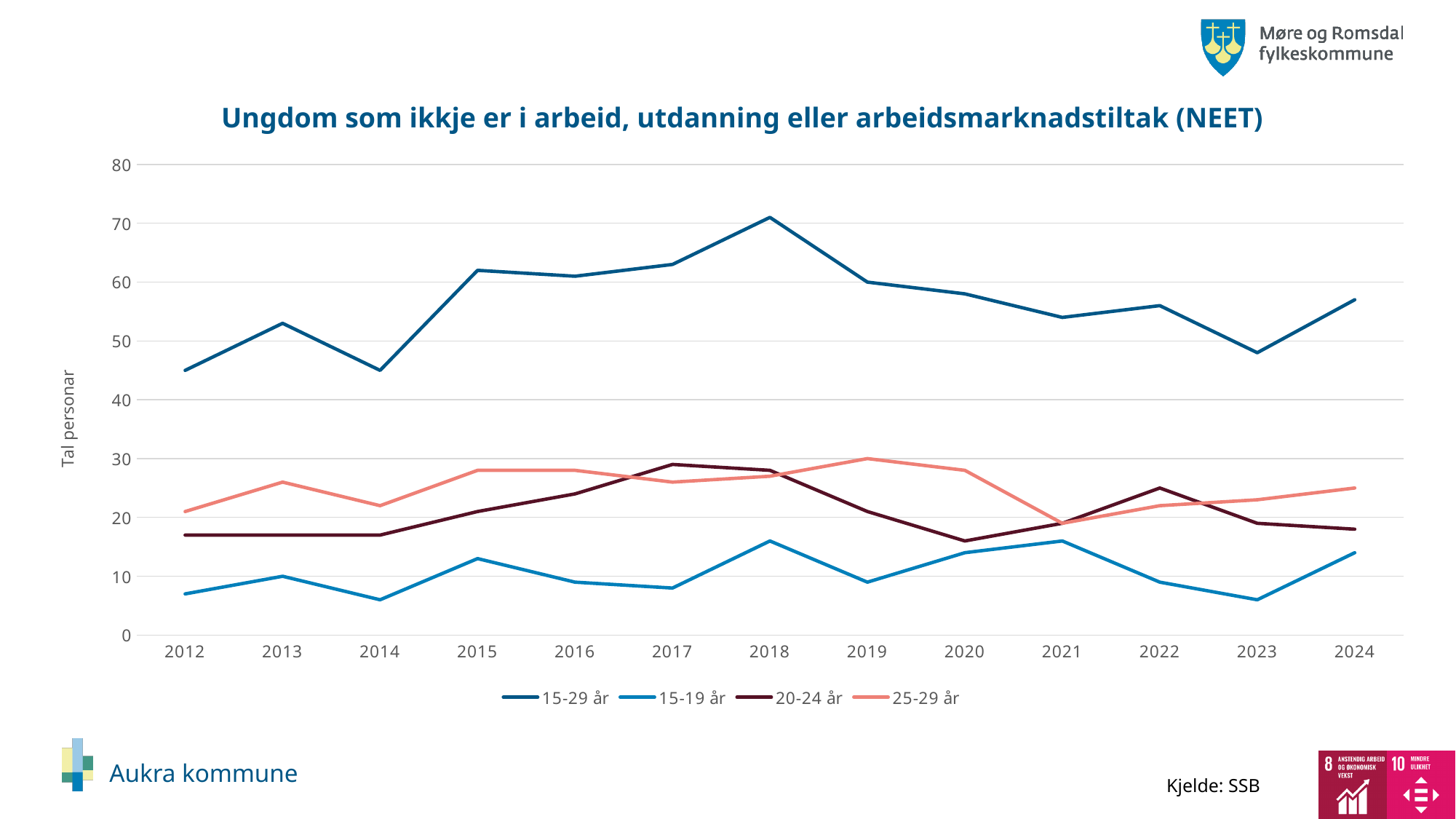
In which year does the 15-29 år series reach its highest value? 2018 Is the value for 15-29 år in 2018 greater or less than 60? greater What source is cited for the chart? SSB In 2024, which series has the larger value: 25-29 år or 20-24 år? 25-29 år Is the value for 15-29 år in 2012 greater or less than 50? less Does the 15-29 år series rise or fall from 2018 to 2021? fall How many series does the legend list? 4 How many years are shown on the x axis? 13 Is the value for 25-29 år in 2013 greater or less than 20? greater What is the label on the y axis? Tal personar What kind of chart is shown on the slide? line chart